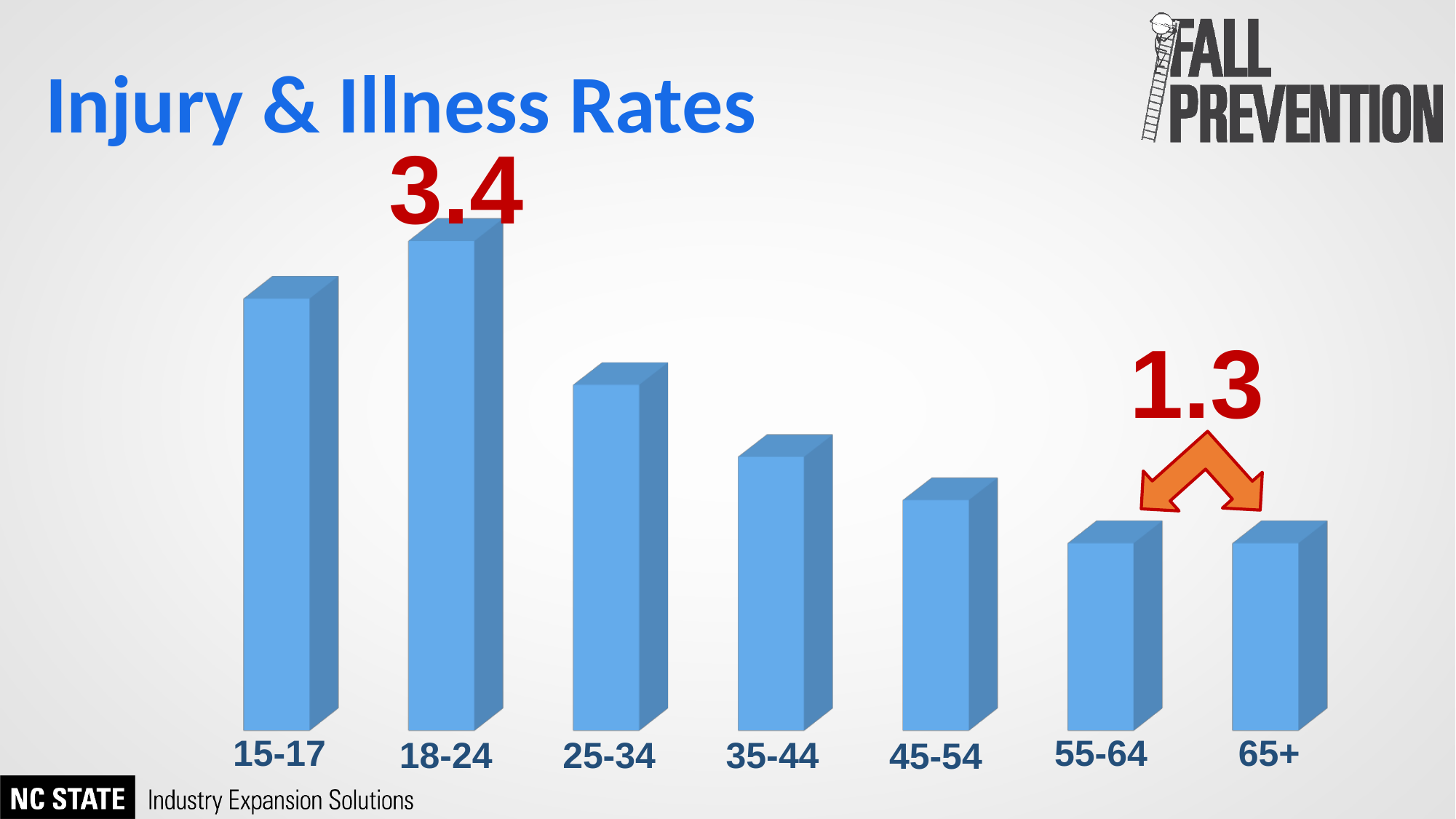
What kind of chart is shown on the slide? Bar chart What is the difference between the rate for the 18-24 age group and the rate for the 65+ age group? 2.1 From the 18-24 age group onward, do the injury and illness rates rise or fall as age increases? Fall Which age group has the larger injury and illness rate, 15-17 or 25-34? 15-17 What is the injury and illness rate for the 18-24 age group? 3.4 What is the title of the slide's chart? Injury & Illness Rates Which two age groups share the rate of 1.3 indicated by the arrow? 55-64 and 65+ Which age group has the larger injury and illness rate, 35-44 or 45-54? 35-44 What is the injury and illness rate for the 55-64 age group? 1.3 What is the injury and illness rate for the 65+ age group? 1.3 How many age groups are shown in the chart? 7 Which age group has the highest injury and illness rate? 18-24